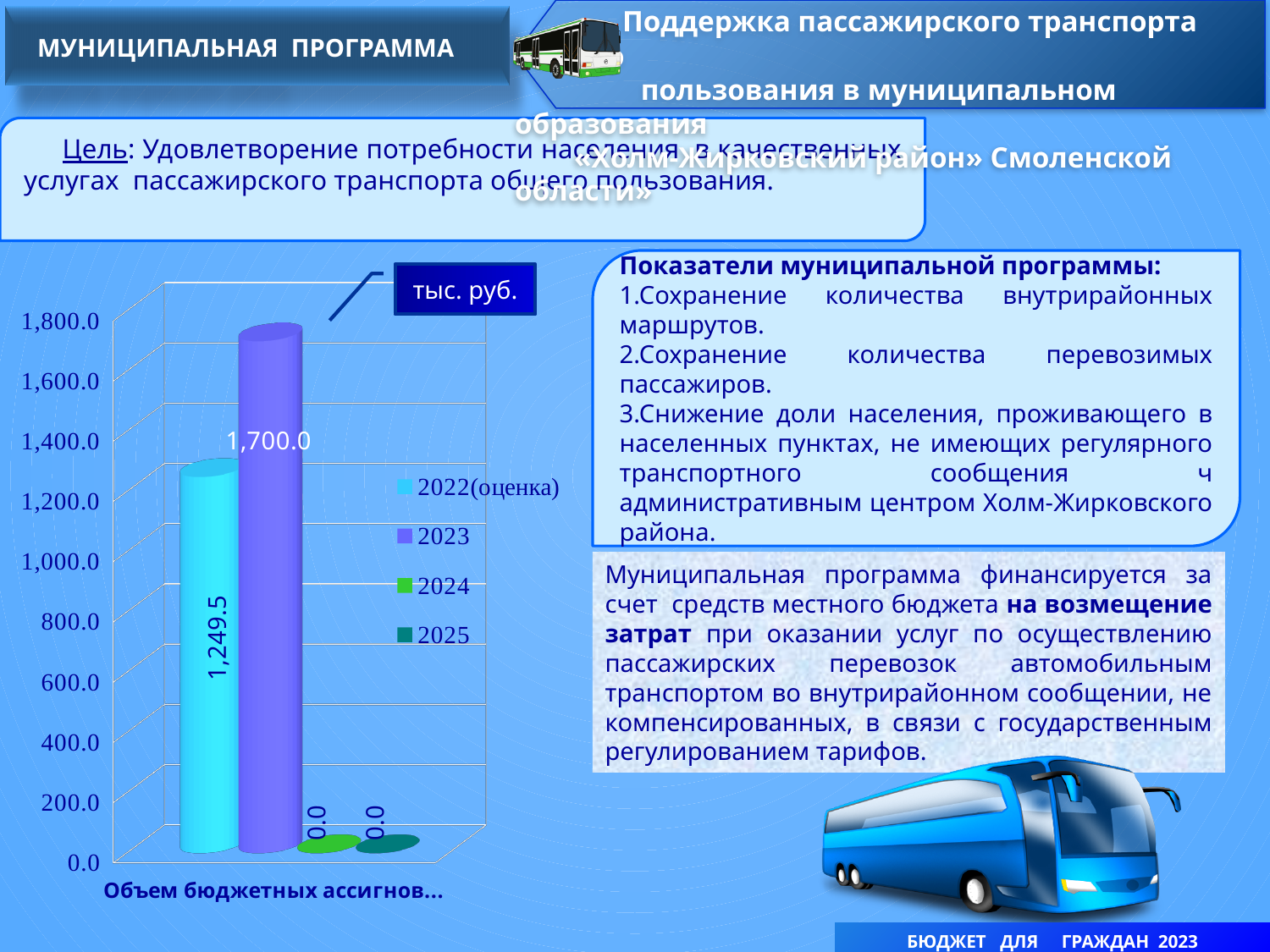
Which series has the highest value on the chart? 2023 What is the value for 2025 on the chart? 0.0 What is the highest tick value shown on the vertical axis of the chart? 1,800.0 Which is larger, the value for 2022(оценка) or the value for 2023? 2023 What is the difference between the values for 2023 and 2022(оценка)? 450.5 How many series does the legend list? 4 What is the value for 2023 on the chart? 1,700.0 What is the value for 2022(оценка) on the chart? 1,249.5 What unit of measurement is shown in the box above the chart? тыс. руб. What is the value for 2024 on the chart? 0.0 What kind of chart is shown on the slide? bar chart Is the value for 2022(оценка) greater or less than 1,200.0? greater